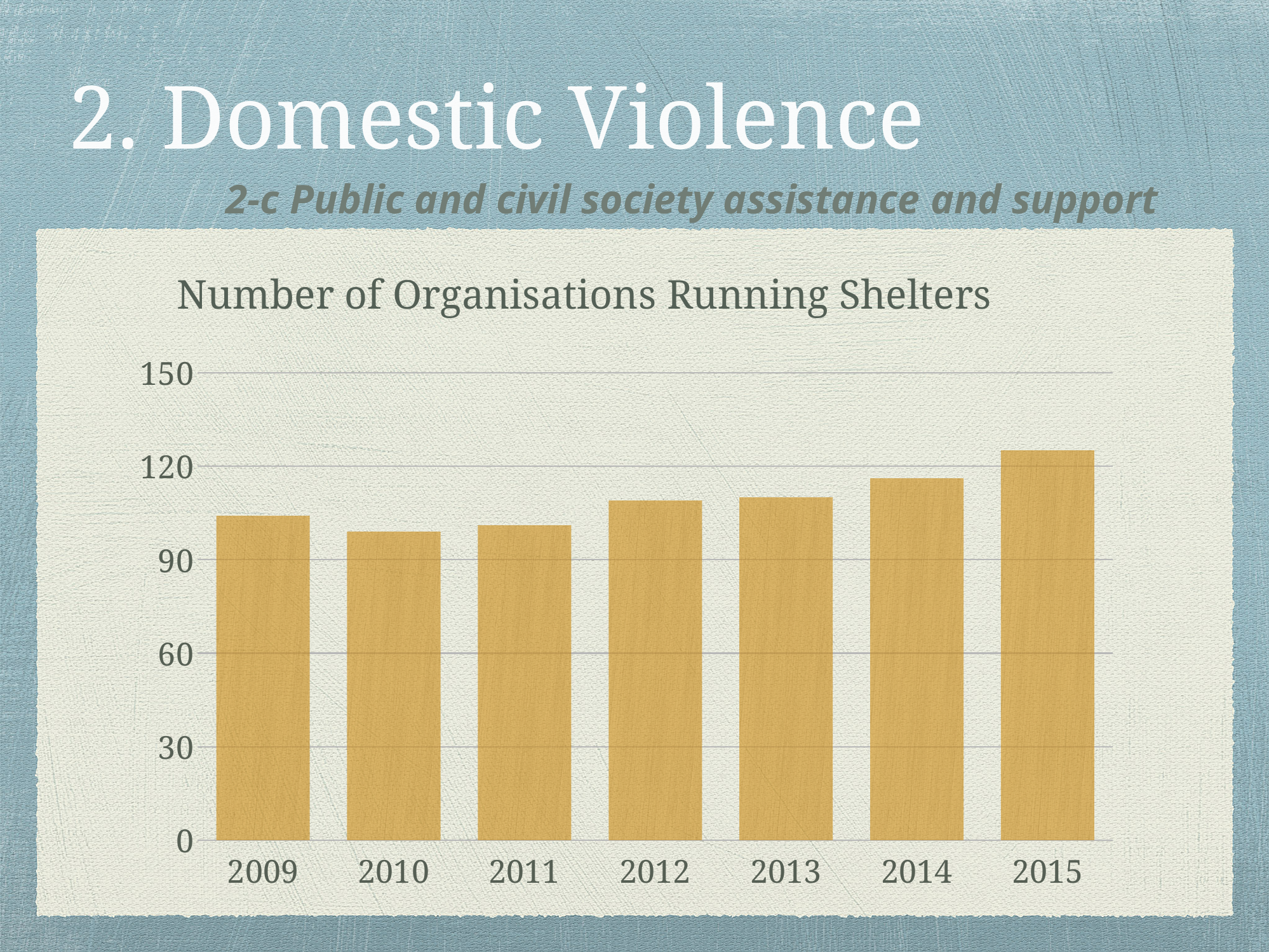
Is the value for 2010 greater or less than 90? greater Is the value for 2012 greater or less than 120? less Which is larger, the value for 2014 or the value for 2011? 2014 Do the values generally rise or fall from 2011 to 2015? rise What kind of chart is shown on the slide? bar chart Is the value for 2015 greater or less than 120? greater Which is larger, the value for 2015 or the value for 2009? 2015 Which year has the highest number of organisations running shelters? 2015 What is the title of the chart? Number of Organisations Running Shelters How many years are shown on the x axis of the chart? 7